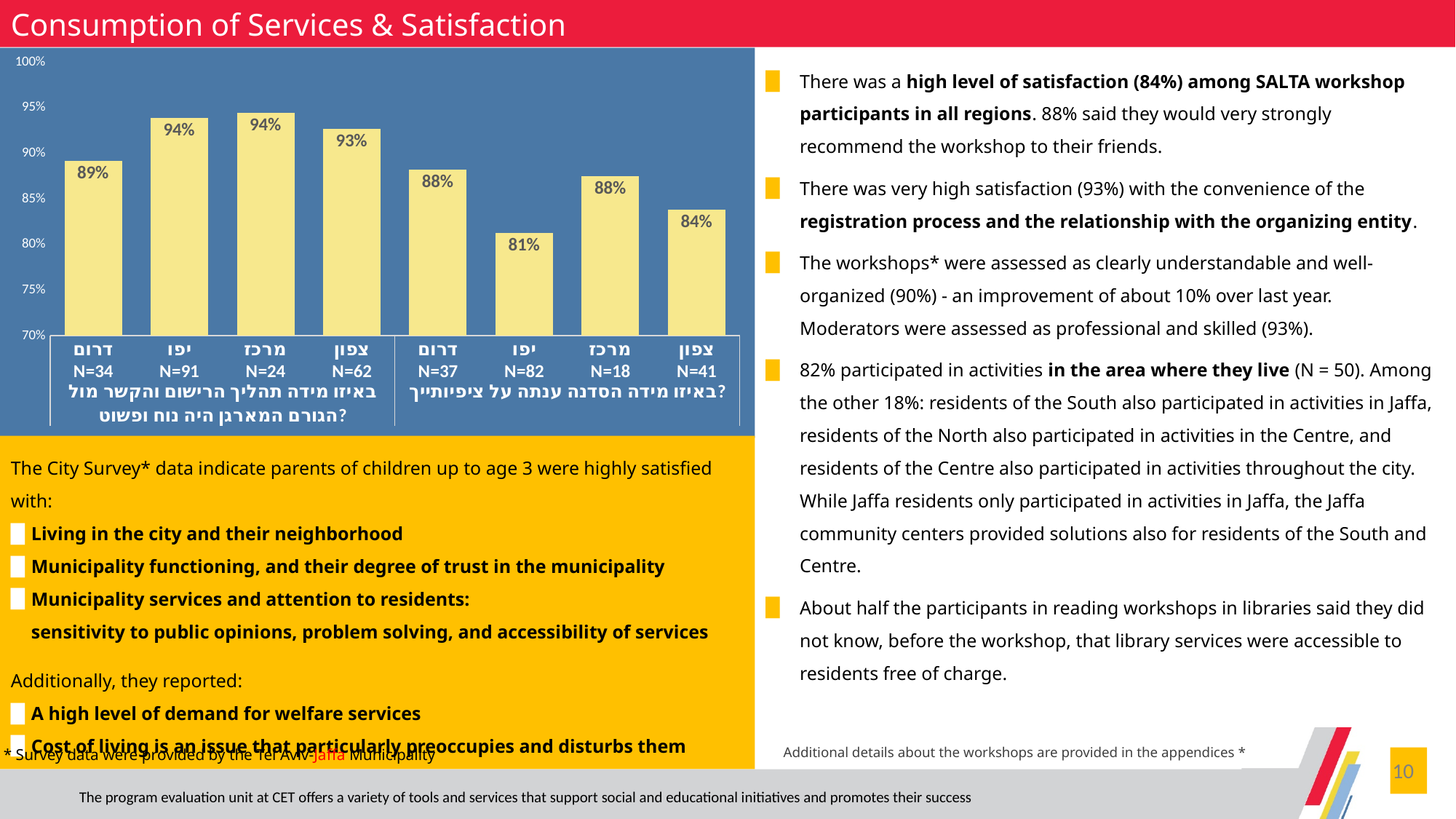
What type of chart is shown on the slide? bar chart What is the difference between the values for יפו (N=91) and יפו (N=82)? 13% What is the difference between the values for מרכז (N=24) and מרכז (N=18)? 6% What is the value for יפו (N=82) in the right group of the chart? 81% What is the value for צפון (N=41) in the right group of the chart? 84% What is the value for צפון (N=62) in the left group of the chart? 93% What is the value for דרום (N=34) in the left group of the chart? 89% Which bar has the lowest value in the chart? יפו (N=82) How many bars are plotted in the chart? 8 Is the value for מרכז (N=18) greater or less than 85%? greater What is the lowest value shown on the y axis of the chart? 70% Which is larger: the value for דרום (N=34) or the value for דרום (N=37)? דרום (N=34)